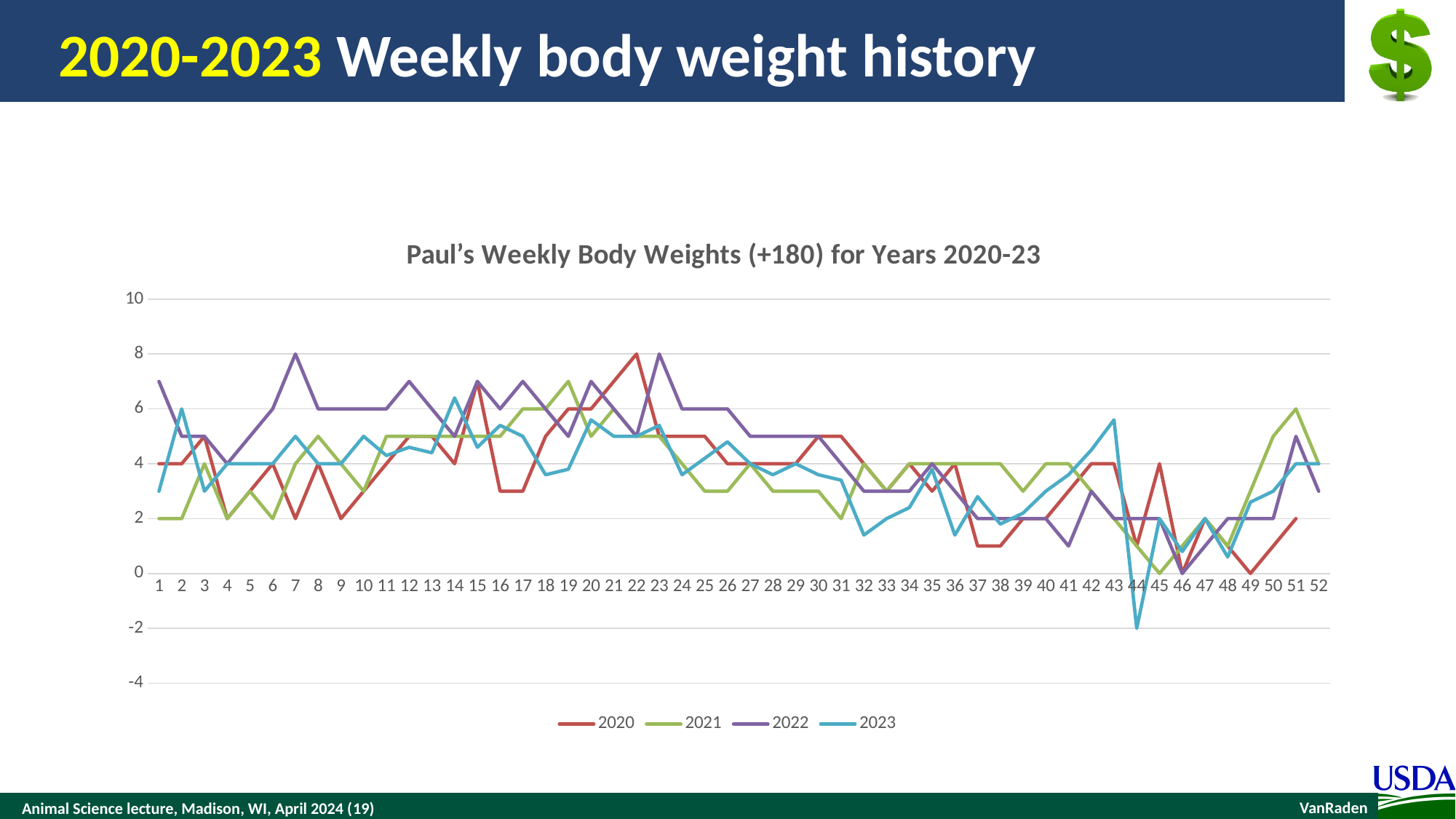
Does the 2022 series generally rise or fall from week 23 to week 46? fall What kind of chart is shown on the slide? line chart How many weeks are shown along the x axis? 52 How many series does the legend list? 4 What is the value for 2023 at week 44? -2 What is the value for 2020 at week 22? 8 Is the value for 2022 at week 23 greater or less than 6? greater Which series has the highest value at week 7? 2022 What is the title of the chart? Paul's Weekly Body Weights (+180) for Years 2020-23 Which colour is used for the 2022 series? purple Which series has the lowest value at week 44? 2023 What is the value for 2022 at week 7? 8